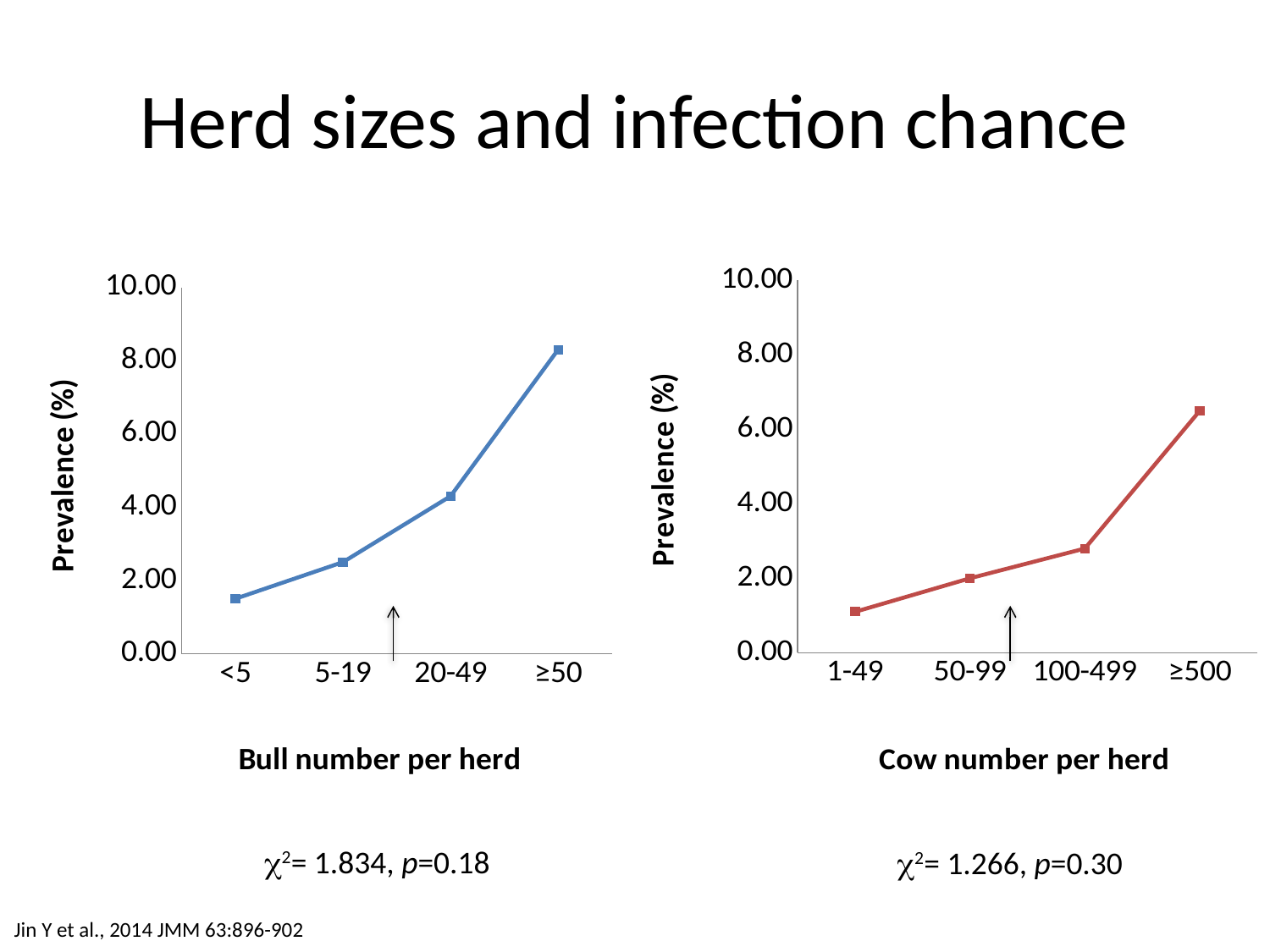
How many herd-size categories are plotted in the left chart (Bull number per herd)? 4 In the right chart (Cow number per herd), is the prevalence for ≥500 greater or less than 4.00? greater In the right chart (Cow number per herd), which herd-size category has the highest prevalence? ≥500 In the left chart (Bull number per herd), which herd-size category has the highest prevalence? ≥50 In the right chart (Cow number per herd), does prevalence rise or fall as cow number per herd increases? rise In the left chart (Bull number per herd), which herd-size category has the lowest prevalence? <5 In the left chart (Bull number per herd), is the prevalence for ≥50 greater or less than 6.00? greater In the left chart (Bull number per herd), is the prevalence for <5 greater or less than 2.00? less In the right chart (Cow number per herd), which has the higher prevalence, 50-99 or 100-499? 100-499 What is the y-axis label of the right chart (Cow number per herd)? Prevalence (%) What type of chart is the left chart (Bull number per herd)? line chart In the right chart (Cow number per herd), which herd-size category has the lowest prevalence? 1-49